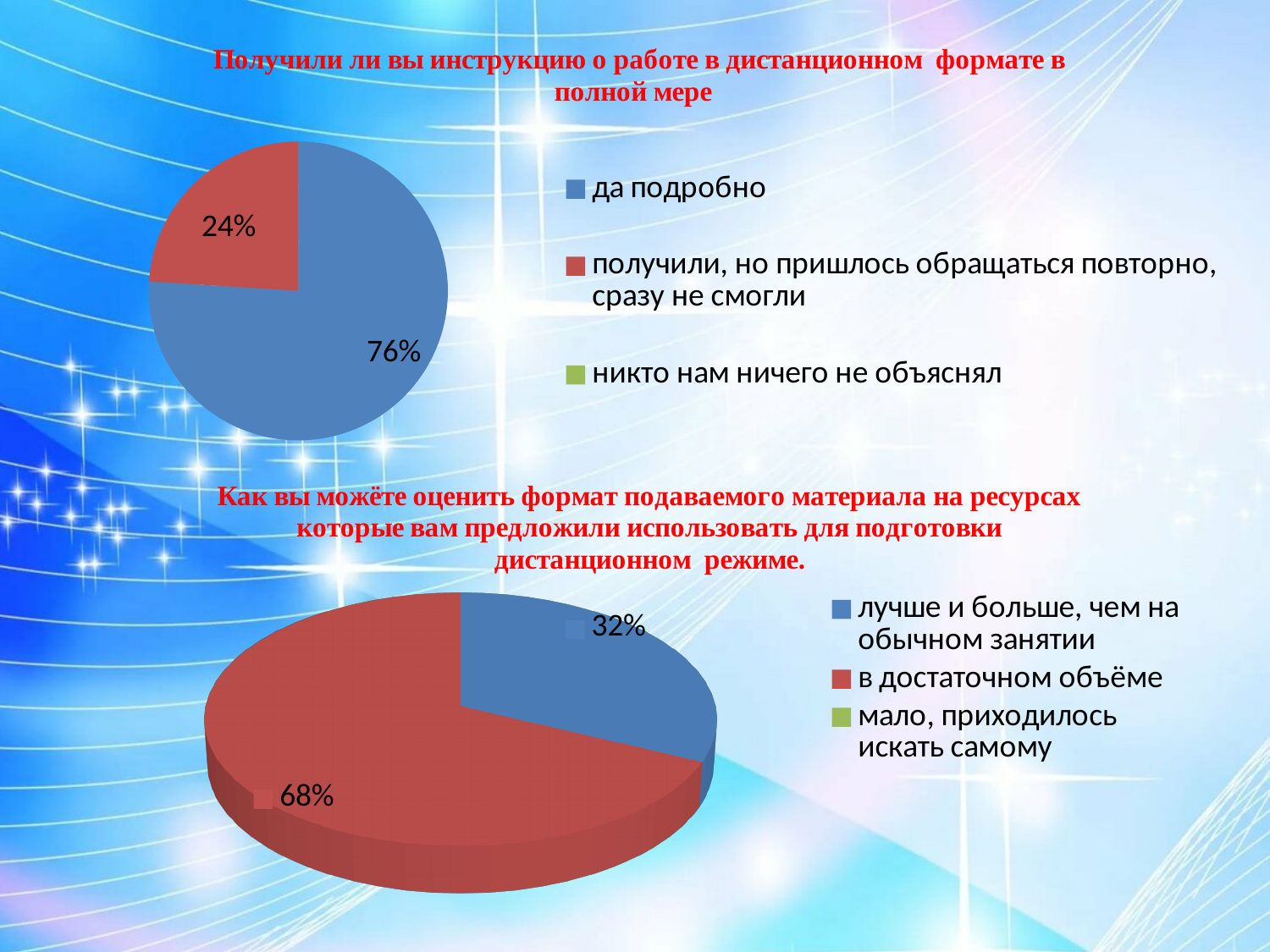
In the bottom pie chart, which is larger: the slice for "в достаточном объёме" or the slice for "лучше и больше, чем на обычном занятии"? в достаточном объёме In the bottom pie chart, what colour is the slice for "в достаточном объёме"? Red In the top pie chart, what share is labelled for "получили, но пришлось обращаться повторно, сразу не смогли"? 24% In the bottom pie chart ("Как вы можёте оценить формат подаваемого материала..."), what share is labelled for "в достаточном объёме"? 68% What type of chart is the top chart on the slide? Pie chart In the top pie chart, what is the difference in percentage points between the "да подробно" slice and the "получили, но пришлось обращаться повторно, сразу не смогли" slice? 52 percentage points In the bottom pie chart, what is the difference in percentage points between the "в достаточном объёме" slice and the "лучше и больше, чем на обычном занятии" slice? 36 percentage points In the top pie chart ("Получили ли вы инструкцию о работе в дистанционном формате в полной мере"), what share is labelled for "да подробно"? 76% In the bottom pie chart, what share is labelled for "лучше и больше, чем на обычном занятии"? 32% In the top pie chart, which legend category has the largest slice? да подробно How many entries does the legend of the bottom pie chart list? 3 How many entries does the legend of the top pie chart list? 3